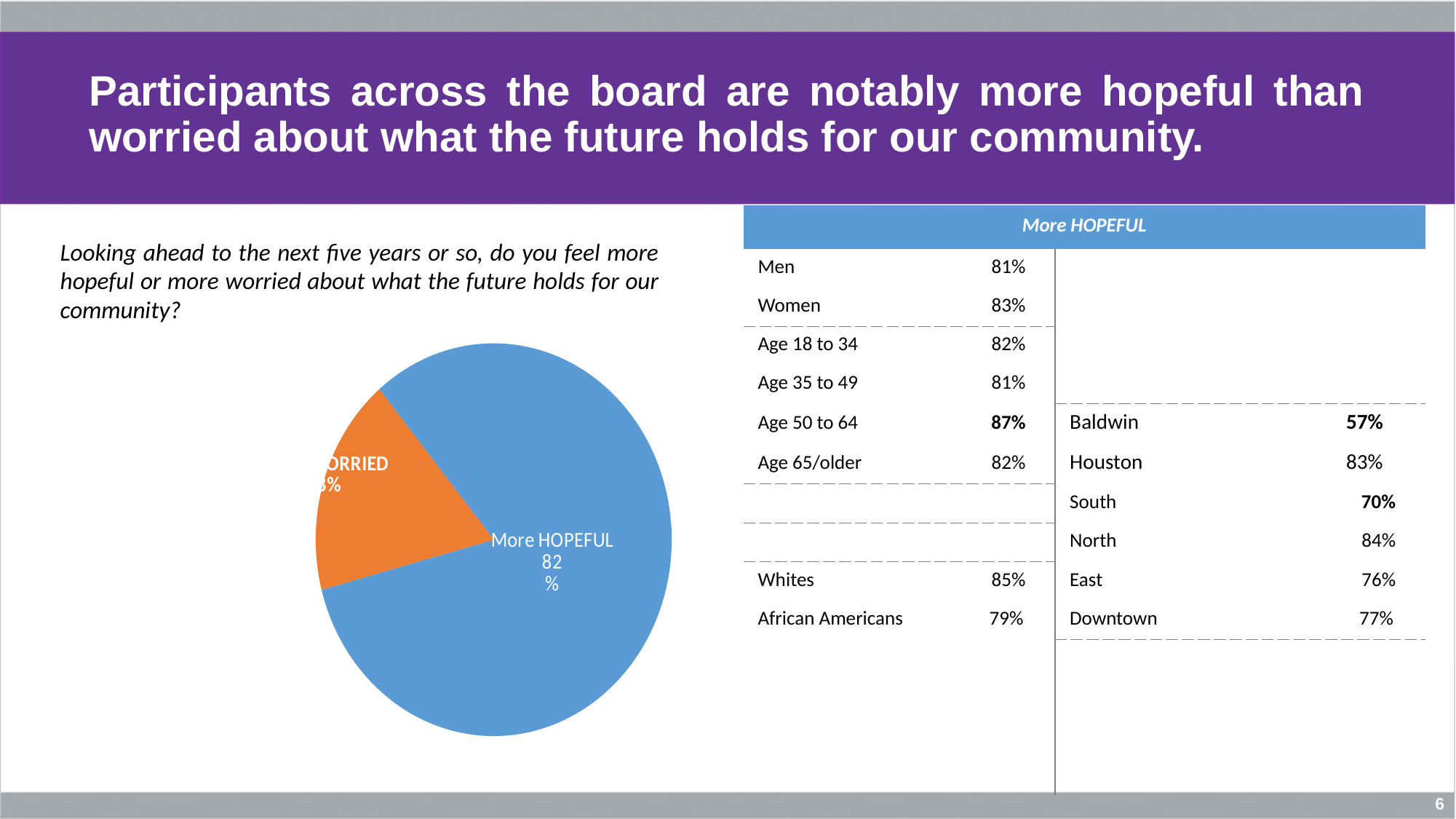
Is the orange slice of the pie chart greater or less than 50%? less Which slice of the pie chart is the largest? More HOPEFUL Is the More HOPEFUL share in the pie chart greater or less than 50%? greater What value is printed on the More HOPEFUL slice of the pie chart? 82% Which is larger in the pie chart, the blue slice or the orange slice? the blue slice What share of the pie chart is labelled More HOPEFUL? 82% What colour is the More HOPEFUL slice of the pie chart? blue What kind of chart is shown on the slide? pie chart How many slices does the pie chart have? 2